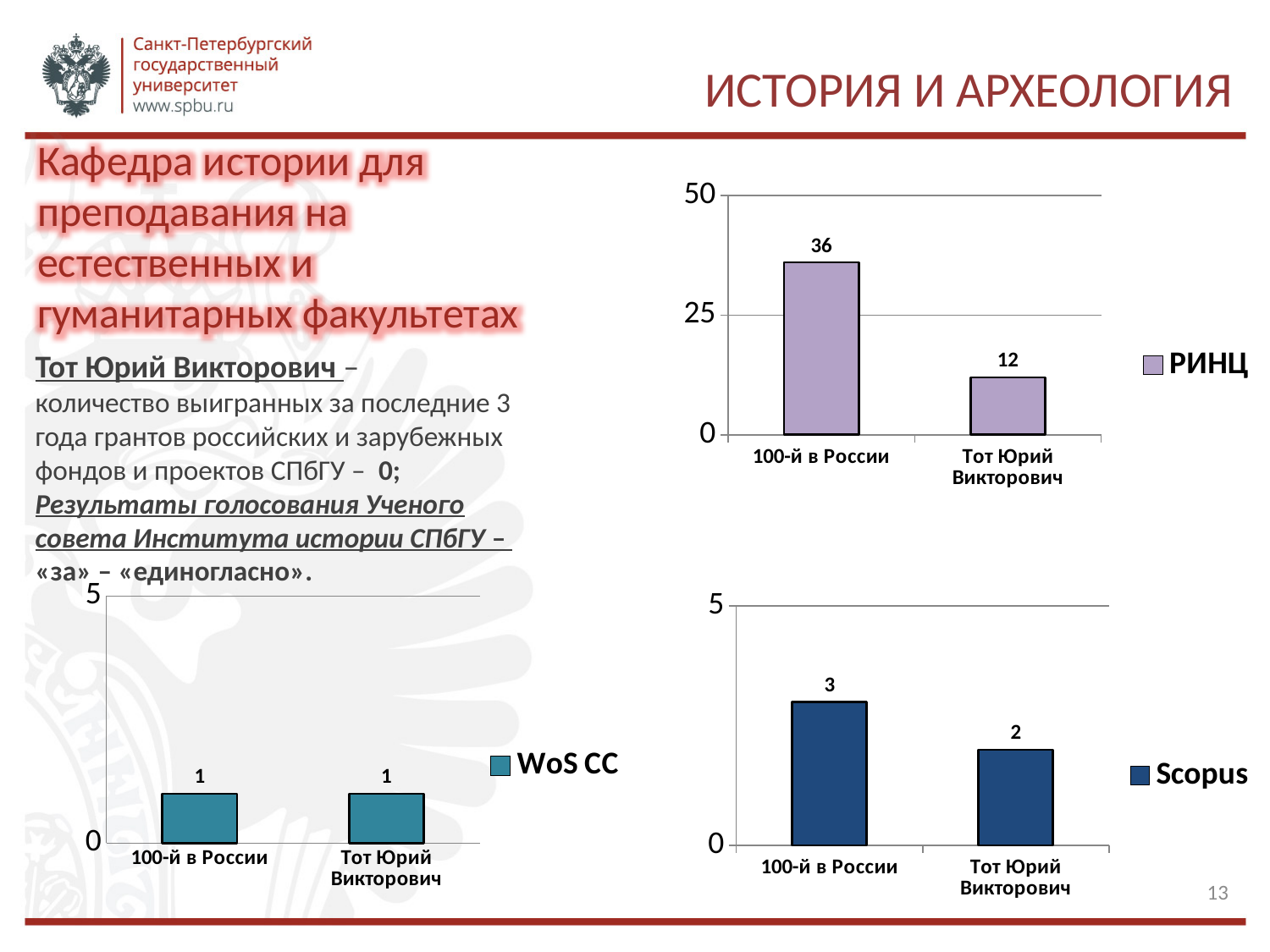
In the Scopus chart (bottom right), what is the value for Тот Юрий Викторович? 2 In the РИНЦ chart (top right), what is the value for Тот Юрий Викторович? 12 In the Scopus chart (bottom right), which category has the lower value? Тот Юрий Викторович In the РИНЦ chart (top right), what is the value for 100-й в России? 36 In the WoS CC chart (bottom left), what is the value for Тот Юрий Викторович? 1 How many categories are shown in the Scopus chart (bottom right)? 2 What series name does the legend of the bottom-left chart show? WoS CC In the WoS CC chart (bottom left), is the value for 100-й в России larger than, smaller than, or equal to the value for Тот Юрий Викторович? equal In the Scopus chart (bottom right), what is the value for 100-й в России? 3 What type of chart is the РИНЦ chart (top right)? bar chart In the РИНЦ chart (top right), what is the difference between the values for 100-й в России and Тот Юрий Викторович? 24 In the РИНЦ chart (top right), which category has the higher value? 100-й в России